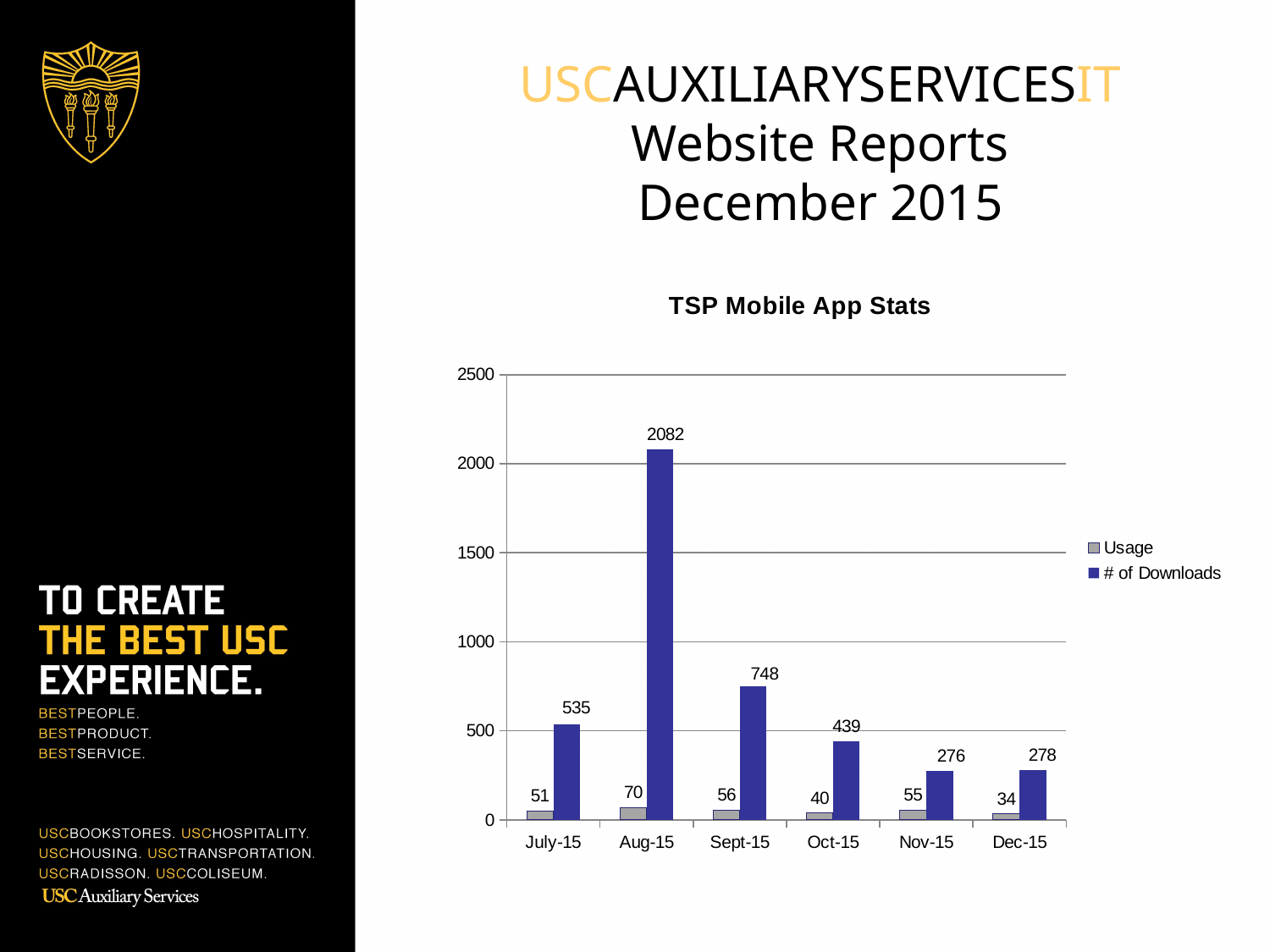
What is the number of downloads for Aug-15? 2082 What is the Usage value for Dec-15? 34 Does the number of downloads rise or fall from Sept-15 to Nov-15? fall Which month has the highest number of downloads? Aug-15 How many months are shown on the x axis? 6 What is the title of the chart? TSP Mobile App Stats Which is larger, the number of downloads in Nov-15 or Dec-15? Dec-15 Is the number of downloads for July-15 greater or less than 1000? less What kind of chart is shown? bar chart How many series does the legend list? 2 Which month has the lowest Usage value? Dec-15 What is the difference between the number of downloads in Sept-15 and Oct-15? 309